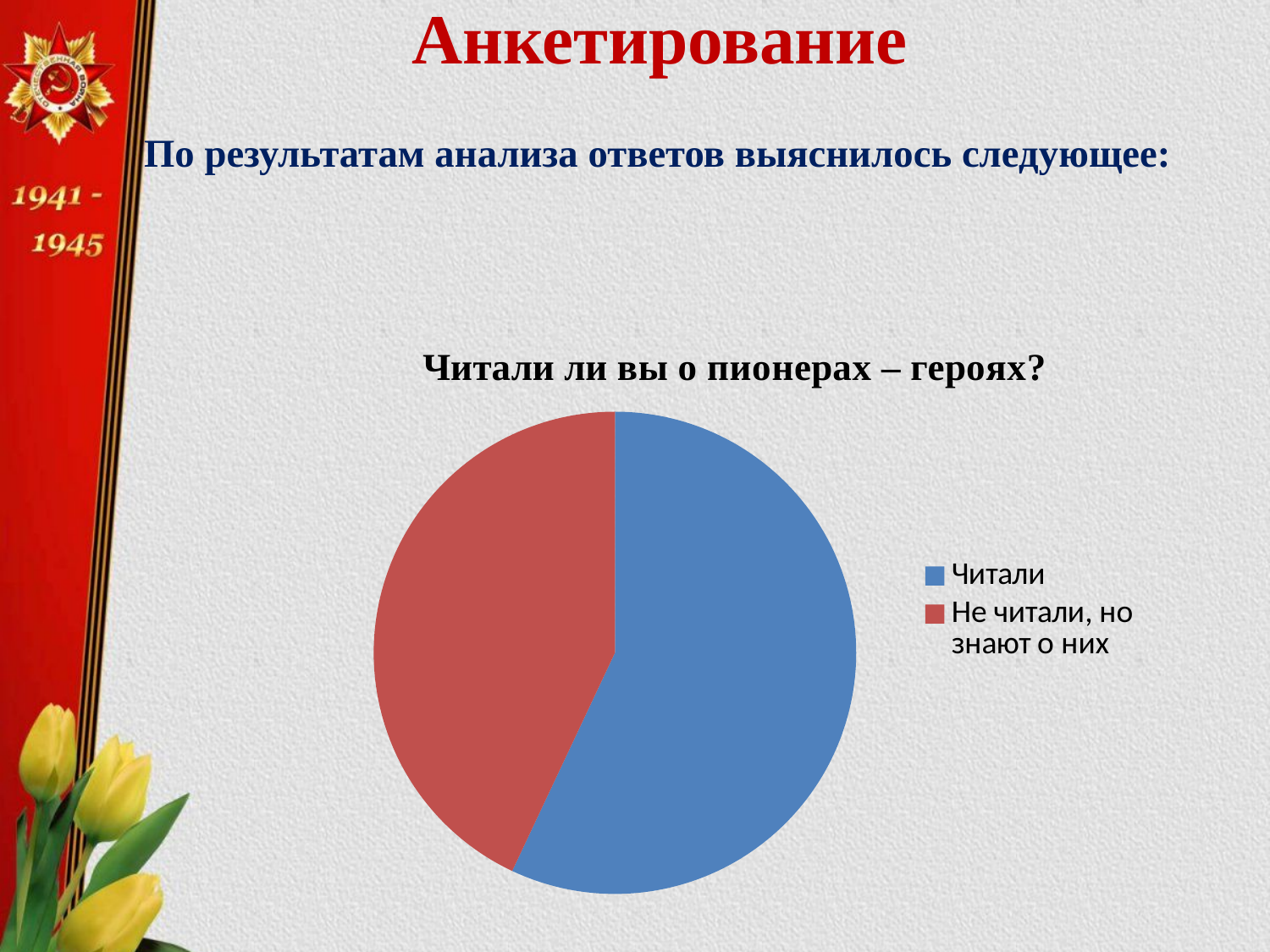
What kind of chart is shown on the slide? pie chart What colour is the slice for "Не читали, но знают о них"? red Which category has the smallest slice in the pie chart? Не читали, но знают о них How many entries does the legend of the pie chart list? 2 Does the slice for "Не читали, но знают о них" take up more or less than half of the pie? less Which category has the largest slice in the pie chart? Читали Does the slice for "Читали" take up more or less than half of the pie? more What is the title of the pie chart? Читали ли вы о пионерах – героях? Which slice is larger: "Читали" or "Не читали, но знают о них"? Читали How many slices does the pie chart have? 2